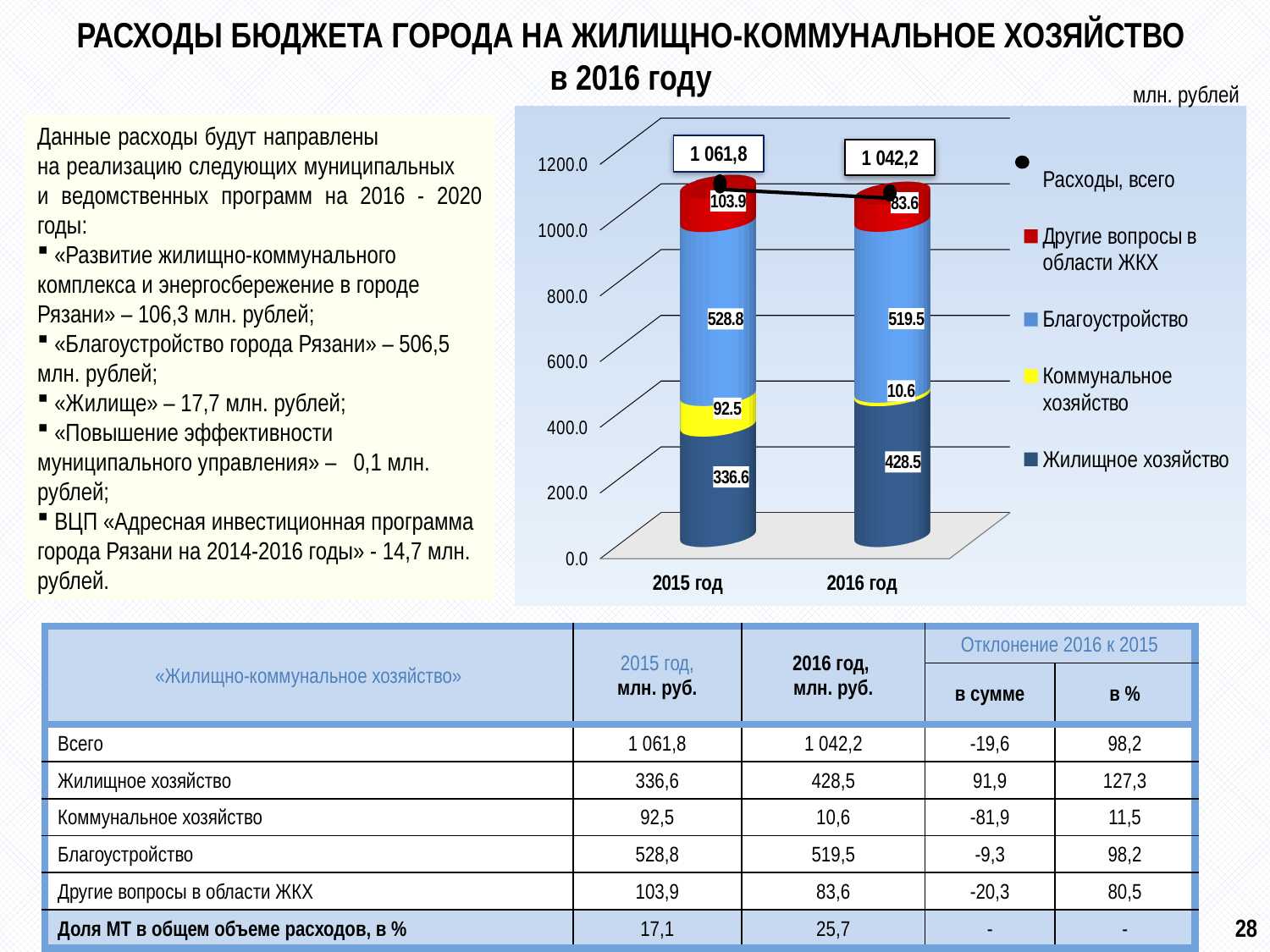
Which year has the higher value for Жилищное хозяйство, 2015 год or 2016 год? 2016 год Which segment is the largest in the 2015 год bar? Благоустройство Which segment is the smallest in the 2016 год bar? Коммунальное хозяйство What is the value for Другие вопросы в области ЖКХ in 2016 год? 83.6 What is the value for Коммунальное хозяйство in 2016 год? 10.6 What is the value of Расходы, всего for 2015 год? 1 061,8 What is the difference between the Коммунальное хозяйство values for 2015 год and 2016 год? 81.9 What is the value for Благоустройство in 2015 год? 528.8 What is the value for Жилищное хозяйство in 2016 год? 428.5 How many series does the legend list? 5 What type of chart is shown? Stacked bar chart Does Расходы, всего rise or fall from 2015 год to 2016 год? Fall